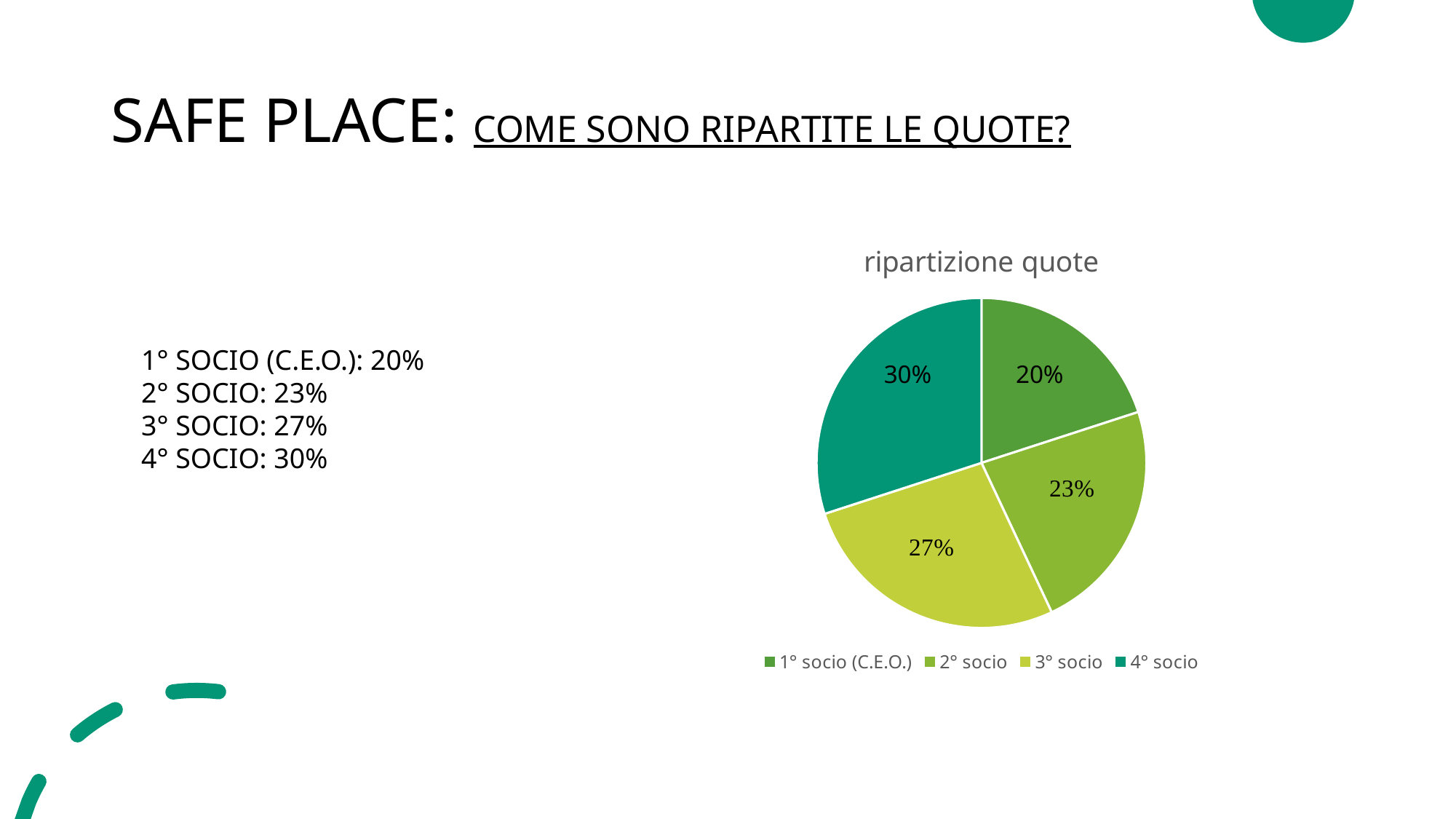
Which slice of the pie is the smallest? 1° socio (C.E.O.) What is the difference between the shares of 4° socio and 1° socio (C.E.O.)? 10% What is the title of the chart? ripartizione quote What kind of chart is shown on the slide? pie chart What share of the pie does 3° socio hold? 27% What share of the pie does 2° socio hold? 23% Which slice of the pie is the largest? 4° socio What share of the pie does 4° socio hold? 30% How many entries does the legend list? 4 Which is larger, the share of 3° socio or the share of 2° socio? 3° socio What share of the pie does 1° socio (C.E.O.) hold? 20% How many slices does the pie chart have? 4